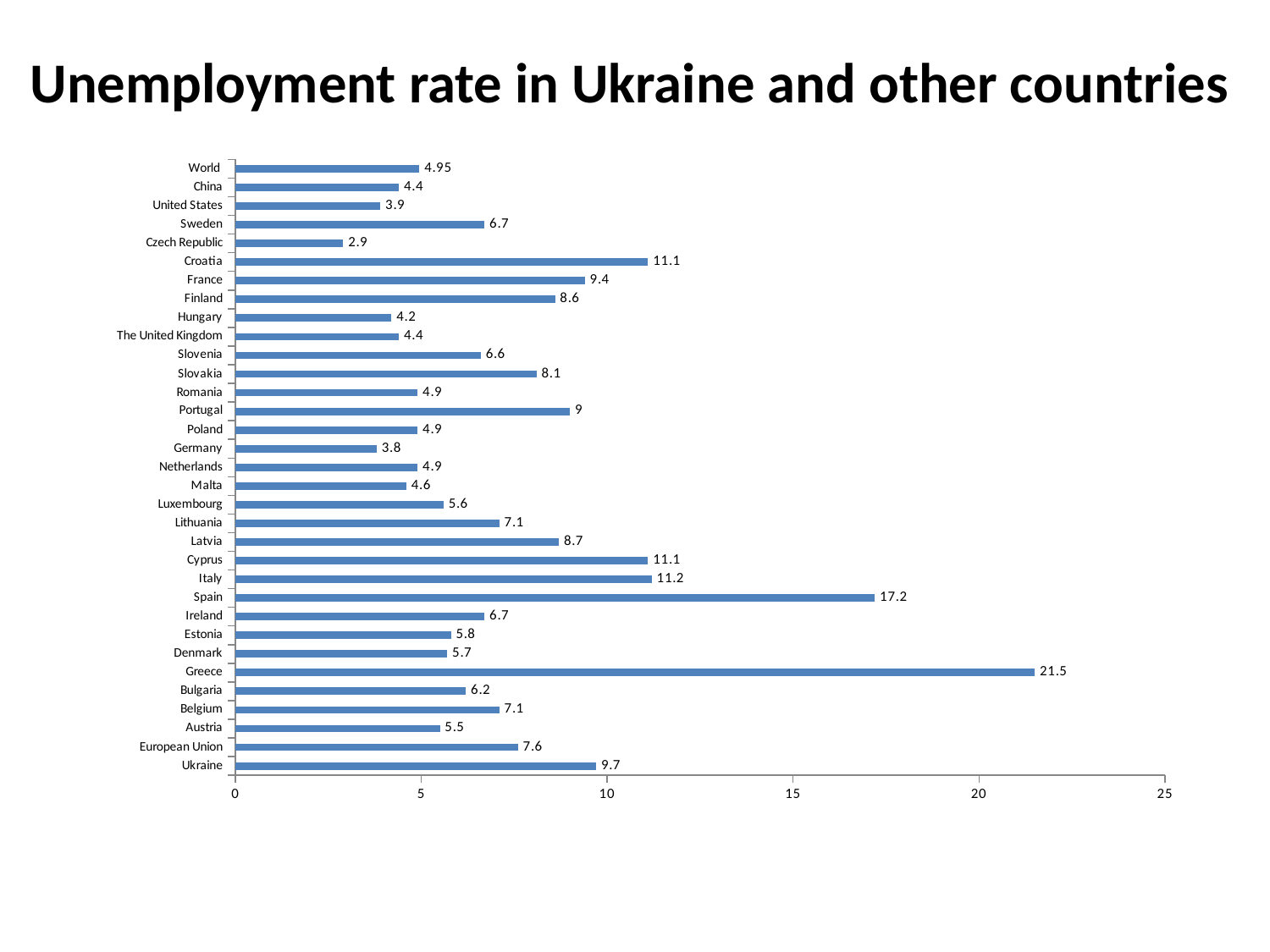
Which country has the lowest unemployment rate on the chart? Czech Republic Is the value for Spain greater or less than 15? greater How many countries or regions are shown on the chart? 33 Which country has the highest unemployment rate on the chart? Greece What type of chart is shown on the slide? Bar chart Which has a higher unemployment rate, France or Finland? France What is the difference between the values for Greece and Spain? 4.3 What is the value shown for the European Union? 7.6 What is the value shown for the World? 4.95 What is the unemployment rate shown for Ukraine? 9.7 What is the difference between the values for Ukraine and the European Union? 2.1 What is the value shown for Greece? 21.5